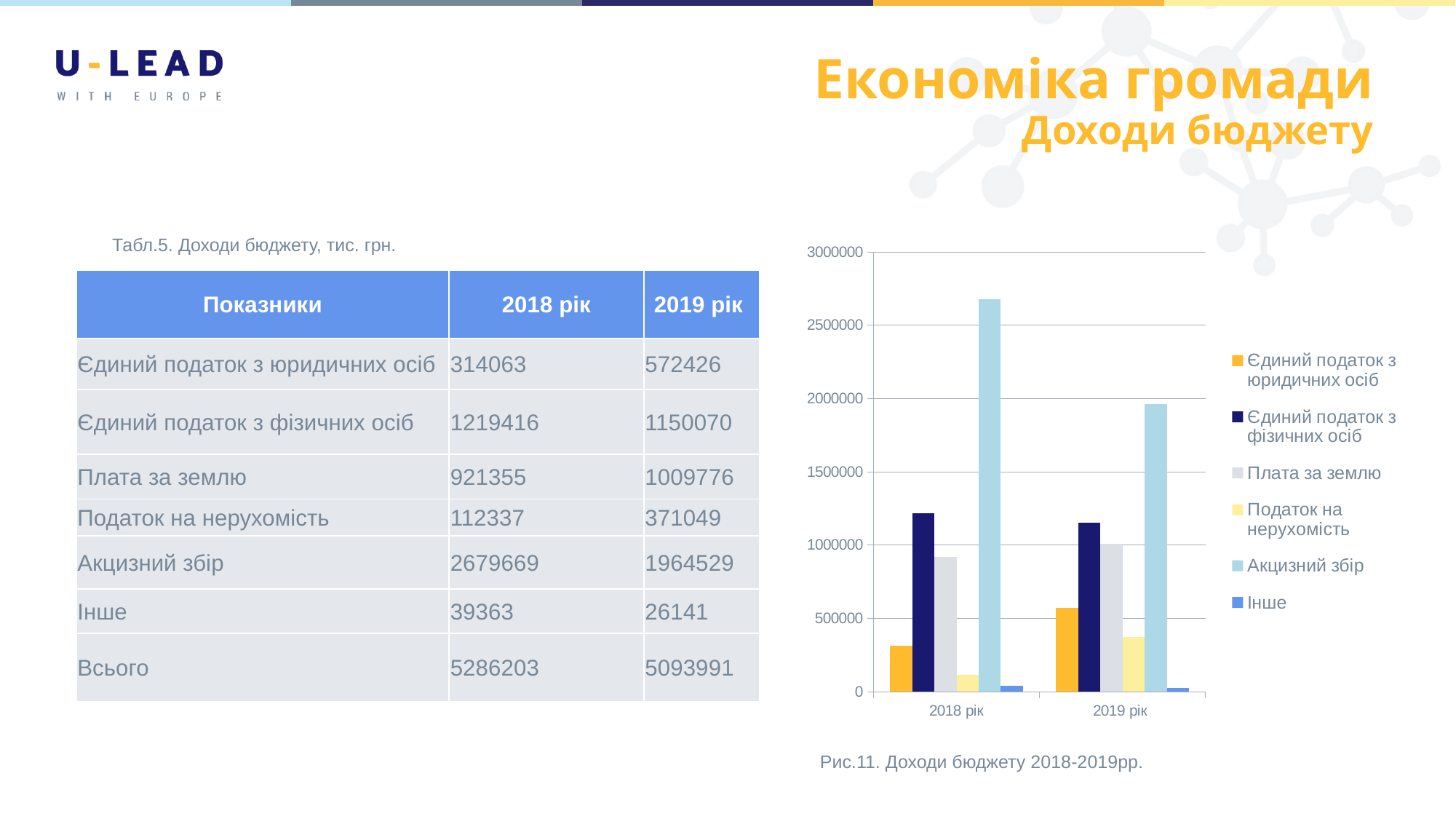
Which series has the shortest bar for 2018 рік? Інше Does the bar for Акцизний збір rise or fall from 2018 рік to 2019 рік? fall What colour represents Акцизний збір in the chart legend? light blue In 2018 рік, which is larger: Плата за землю or Єдиний податок з фізичних осіб? Єдиний податок з фізичних осіб According to the slide, what is the value of Акцизний збір for 2018 рік? 2679669 How many year categories are shown on the x axis of the chart? 2 What kind of chart is shown on the right of the slide? bar chart How many series does the chart legend list? 6 Is the value for Єдиний податок з фізичних осіб in 2018 рік greater or less than 1000000? greater Does the bar for Єдиний податок з юридичних осіб rise or fall from 2018 рік to 2019 рік? rise Is the value for Акцизний збір in 2018 рік greater or less than 2500000? greater Which series has the tallest bar for 2018 рік? Акцизний збір